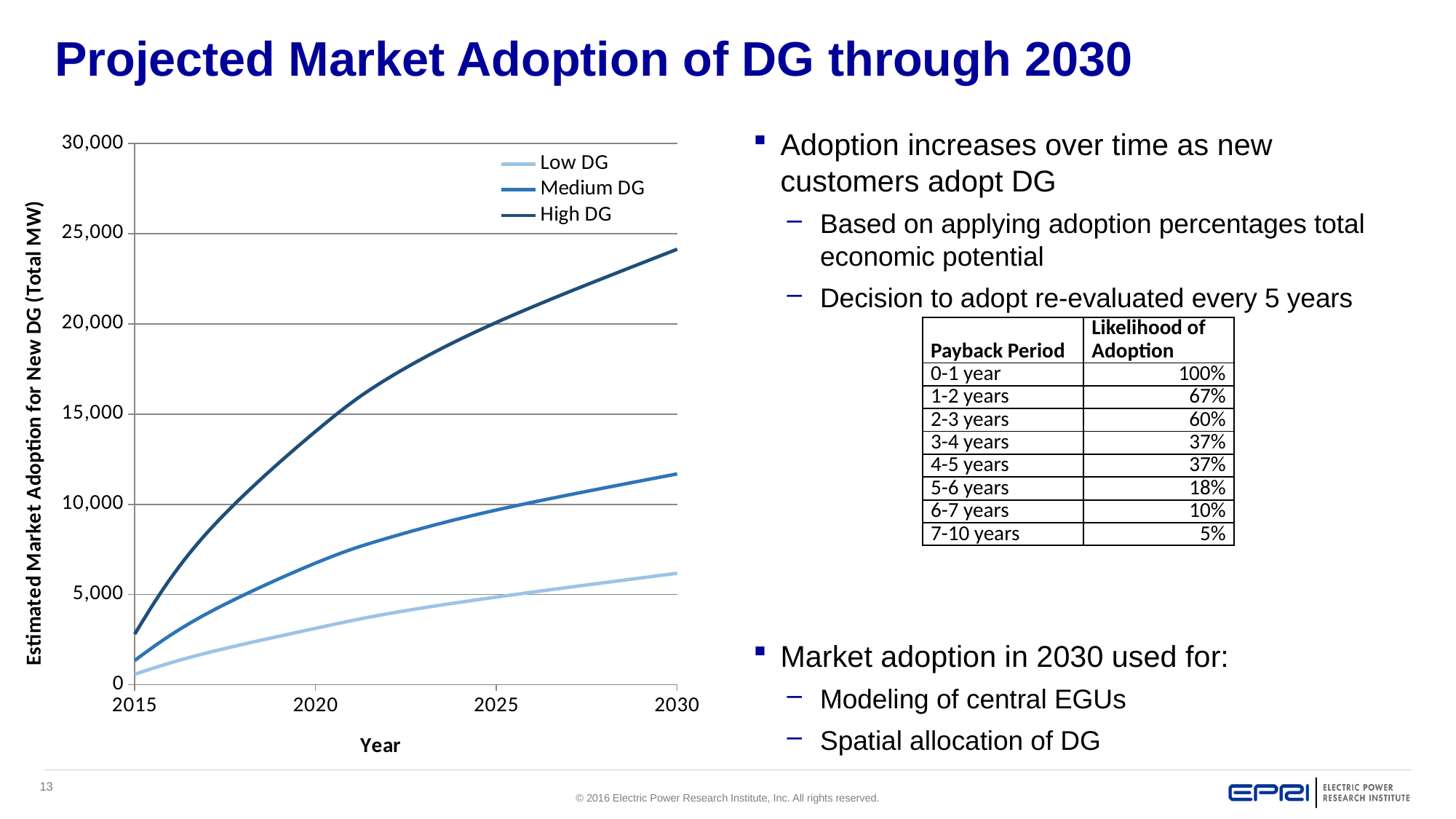
Which is larger in 2020, Medium DG or Low DG? Medium DG Is the value for Low DG in 2030 greater or less than 5,000? greater What is the title of the x axis of the chart? Year Is the value for Medium DG in 2030 greater or less than 10,000? greater What kind of chart is shown on the slide? line chart How many series does the chart legend list? 3 Which series has the lowest value in 2030? Low DG Do the values for High DG rise or fall from 2015 to 2030? rise Which series has the highest value in 2030? High DG Is the value for Low DG in 2020 greater or less than 5,000? less